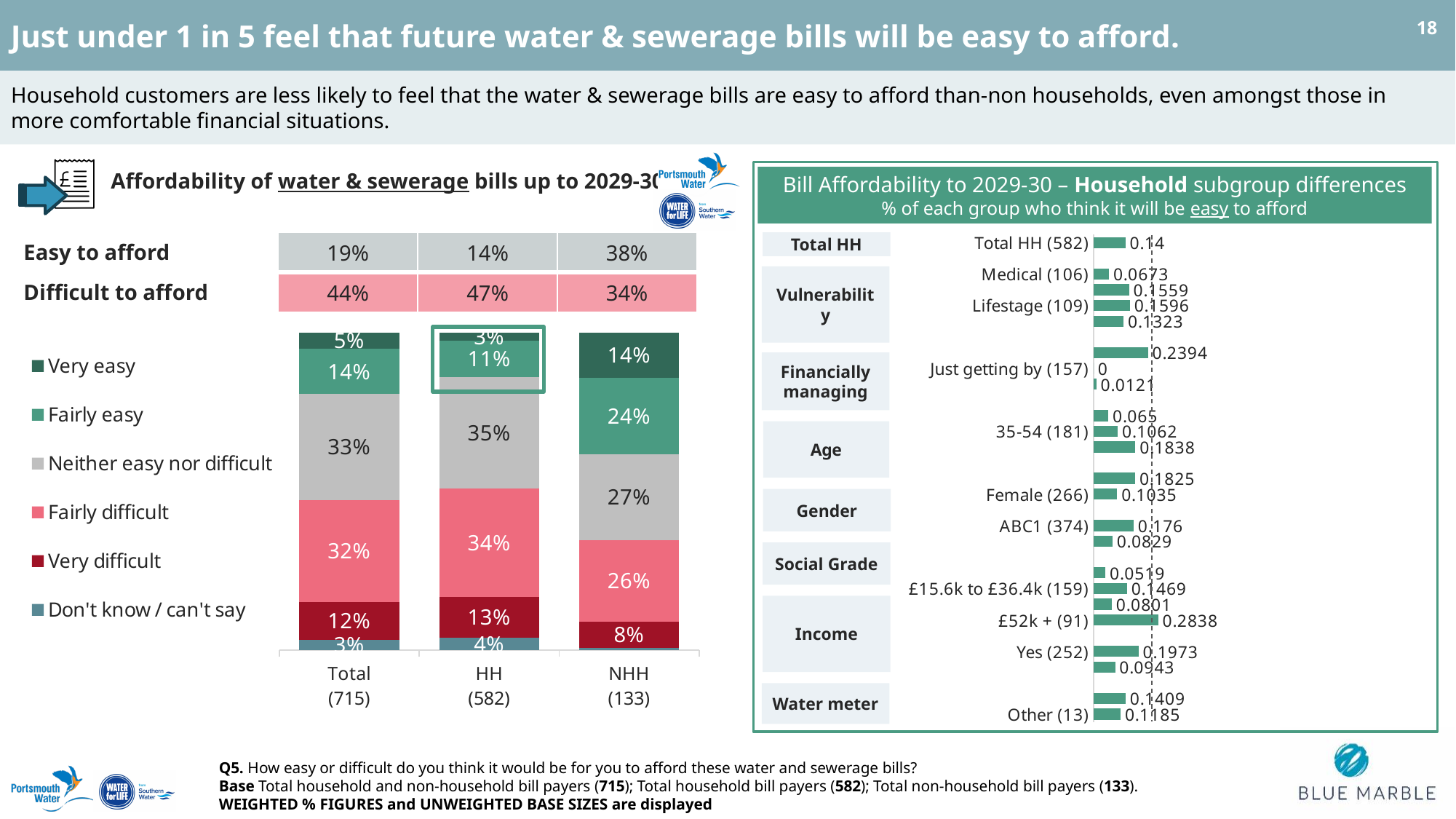
In the left chart 'Affordability of water & sewerage bills up to 2029-30', what is the difference between the 'Very difficult' values for HH and NHH? 5% In the right chart 'Bill Affordability to 2029-30 – Household subgroup differences', which labelled subgroup has the lowest value? Just getting by (157) How many series does the legend of the left chart 'Affordability of water & sewerage bills up to 2029-30' list? 6 In the right chart 'Bill Affordability to 2029-30 – Household subgroup differences', what is the value for Total HH (582)? 0.14 In the left chart 'Affordability of water & sewerage bills up to 2029-30', what percentage of HH (582) respondents said 'Neither easy nor difficult'? 35% In the right chart 'Bill Affordability to 2029-30 – Household subgroup differences', what is the value for £52k + (91)? 0.2838 In the left chart 'Affordability of water & sewerage bills up to 2029-30', what is the 'Easy to afford' summary figure for NHH? 38% In the left chart 'Affordability of water & sewerage bills up to 2029-30', which group has the highest 'Difficult to afford' summary figure? HH (582) What kind of chart is the left chart 'Affordability of water & sewerage bills up to 2029-30'? Stacked bar chart In the left chart 'Affordability of water & sewerage bills up to 2029-30', what percentage of NHH (133) respondents said 'Fairly easy'? 24% In the right chart 'Bill Affordability to 2029-30 – Household subgroup differences', is the value for ABC1 (374) larger or smaller than the value for Female (266)? Larger In the left chart 'Affordability of water & sewerage bills up to 2029-30', is the 'Fairly difficult' value larger for Total or for HH? HH